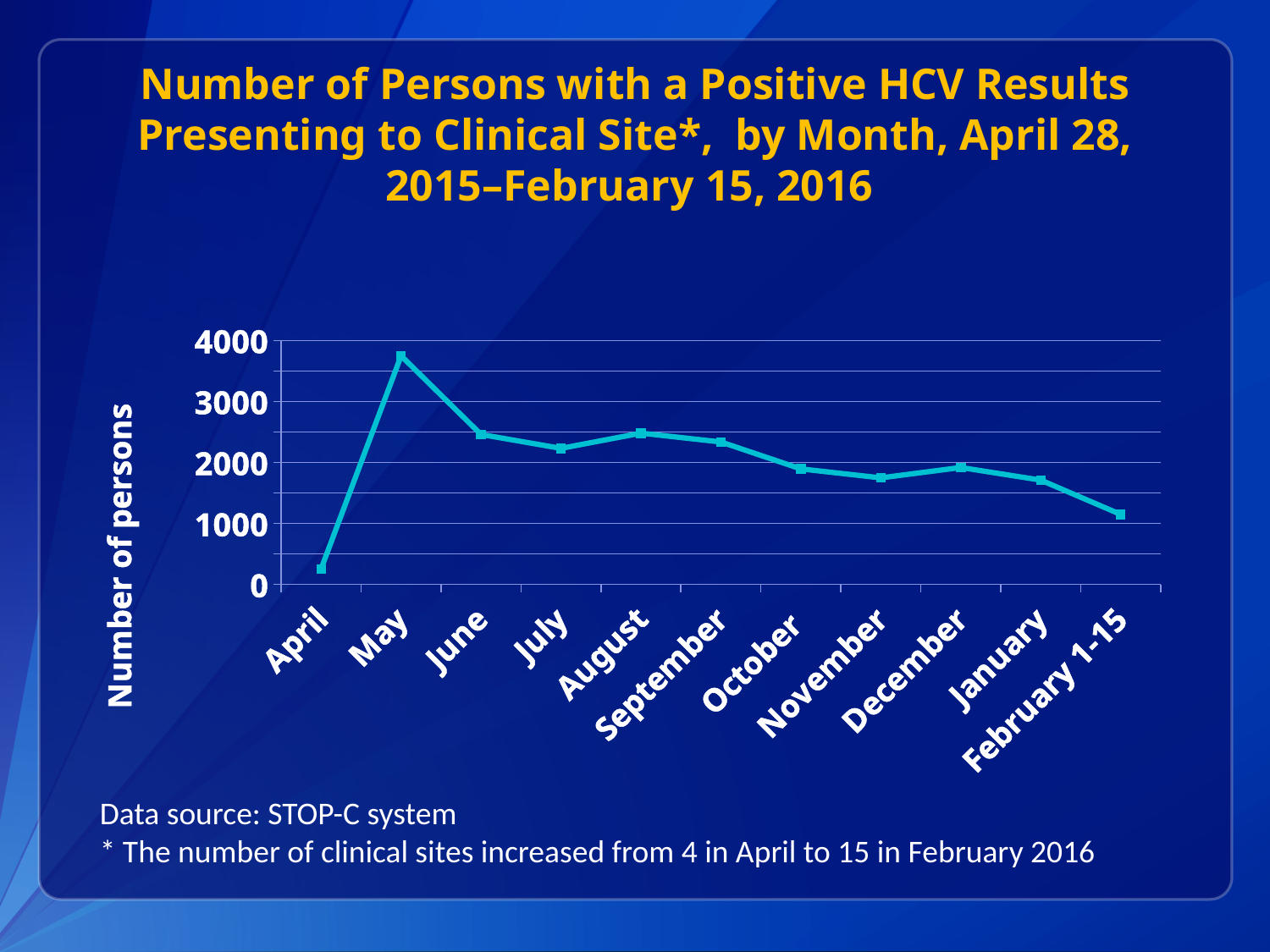
Which is larger, the value for May or the value for June? May Is the value for May greater or less than 3000? greater What is the label on the vertical axis? Number of persons What kind of chart is shown on the slide? line chart Is the value for November greater or less than 2000? less Which month has the lowest number of persons with a positive HCV result? April How many months (data points) are plotted on the x axis? 11 Which month has the highest number of persons with a positive HCV result? May Do the values rise or fall from May through February 1-15? fall Is the value for April greater or less than 1000? less